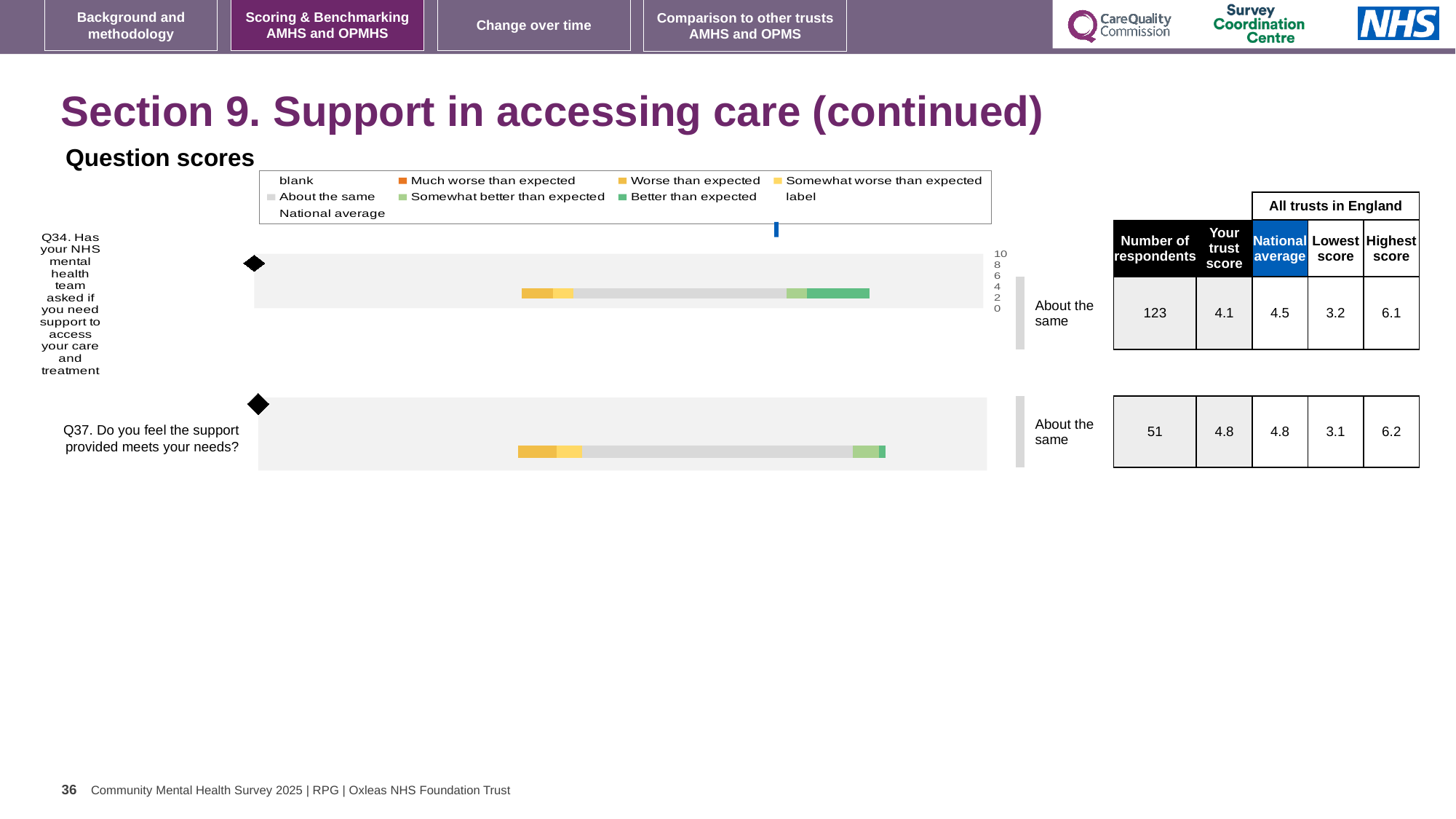
How many legend entries in the question scores chart contain the word 'expected'? 5 What kind of chart is used to show the question scores on this slide? bar chart What is the lowest score among all trusts in England for Q34? 3.2 What is the trust score for Q37 (Do you feel the support provided meets your needs)? 4.8 How many questions are plotted in the question scores chart? 2 How many respondents answered Q34? 123 What is the difference between the trust scores for Q37 and Q34? 0.7 What is the highest score among all trusts in England for Q37? 6.2 What is the trust score for Q34 (Has your NHS mental health team asked if you need support to access your care and treatment)? 4.1 Which question has the higher trust score, Q34 or Q37? Q37 What is the national average score for Q34? 4.5 What benchmark category is shown next to the bar for Q37? About the same